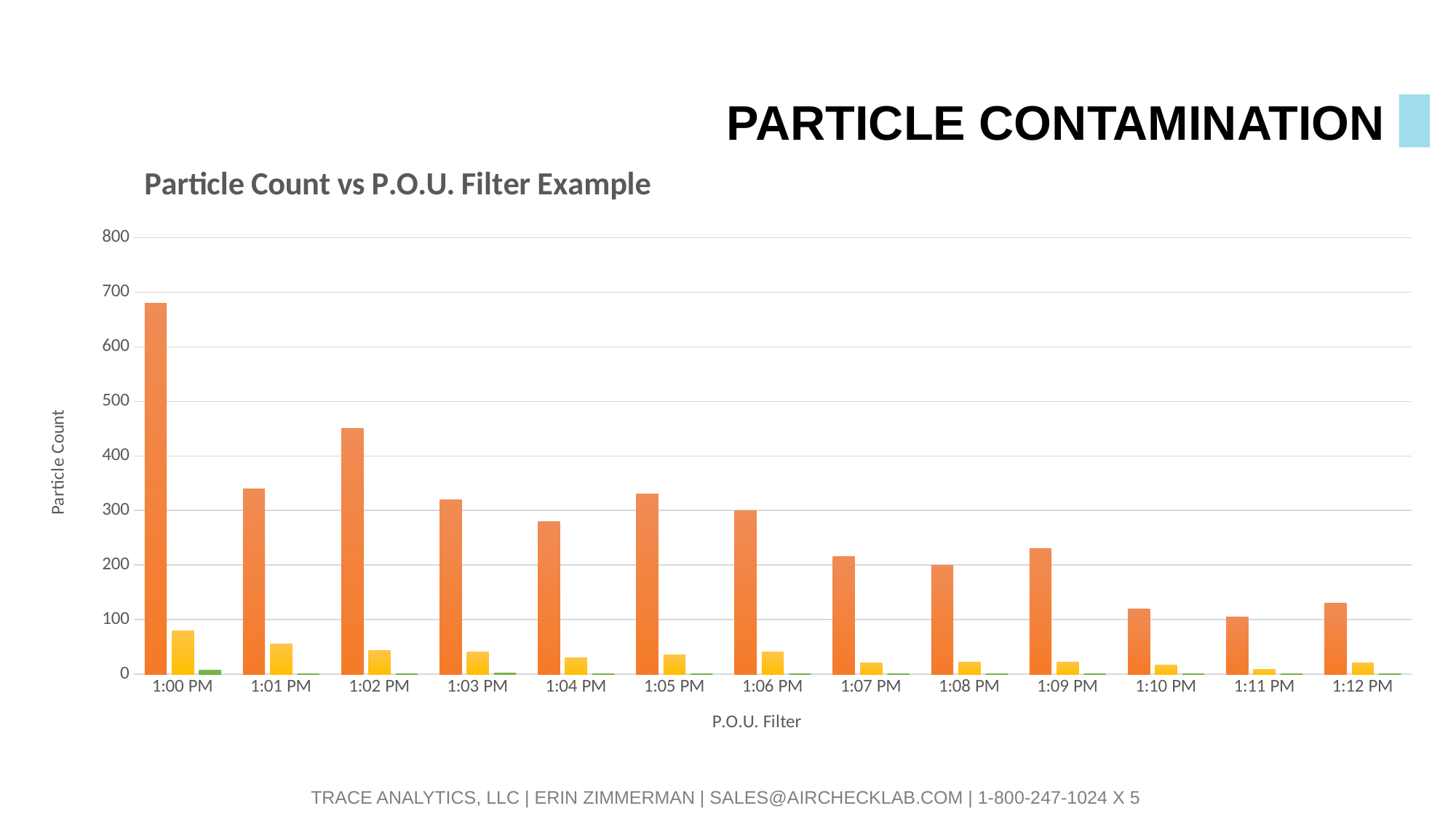
What is the label on the vertical axis of the chart? Particle Count Is the orange bar at 1:02 PM greater or less than 400? greater Is the yellow bar at 1:00 PM greater or less than 100? less What kind of chart is shown on the slide? bar chart At which time is the orange bar the highest? 1:00 PM Is the orange bar at 1:11 PM greater or less than 200? less What is the title of the chart? Particle Count vs P.O.U. Filter Example How many time categories are shown on the x axis? 13 Which has the larger orange bar, 1:01 PM or 1:02 PM? 1:02 PM Do the orange bars generally rise or fall from 1:00 PM to 1:12 PM? fall